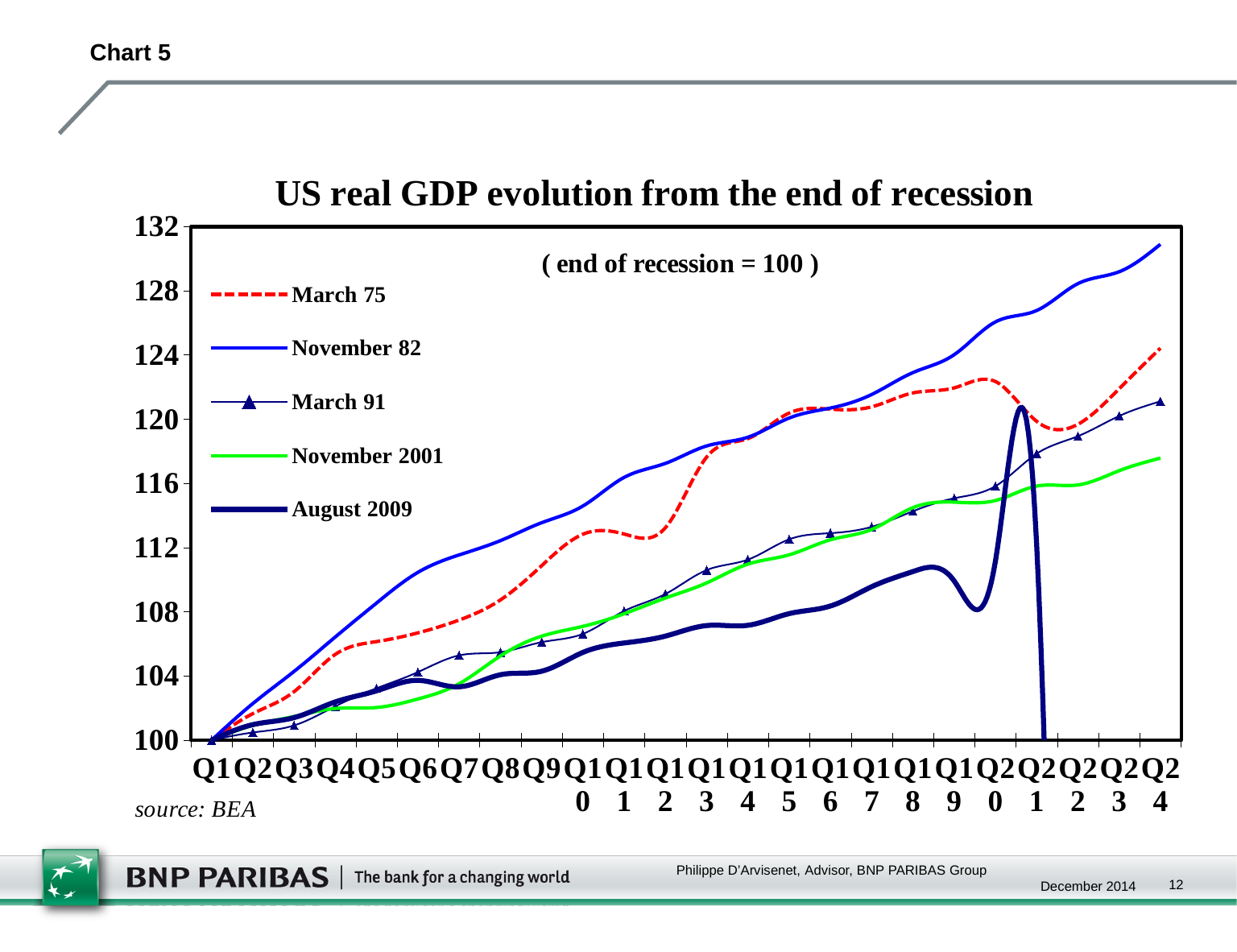
What kind of chart is shown on the slide? line chart What is the title of the chart? US real GDP evolution from the end of recession Does the November 82 series rise or fall from Q1 to Q24? rise Is the value for August 2009 at Q18 greater or less than 112? less At Q10, which series is higher: November 82 or November 2001? November 82 Is the value for November 2001 at Q24 greater or less than 120? less Which series has the highest value at Q24? November 82 How many quarters are shown along the x axis? 24 What value is the end of recession set equal to, according to the chart's subtitle? 100 Is the value for November 82 at Q24 greater or less than 128? greater How many series does the legend list? 5 What is the value of every series at Q1? 100